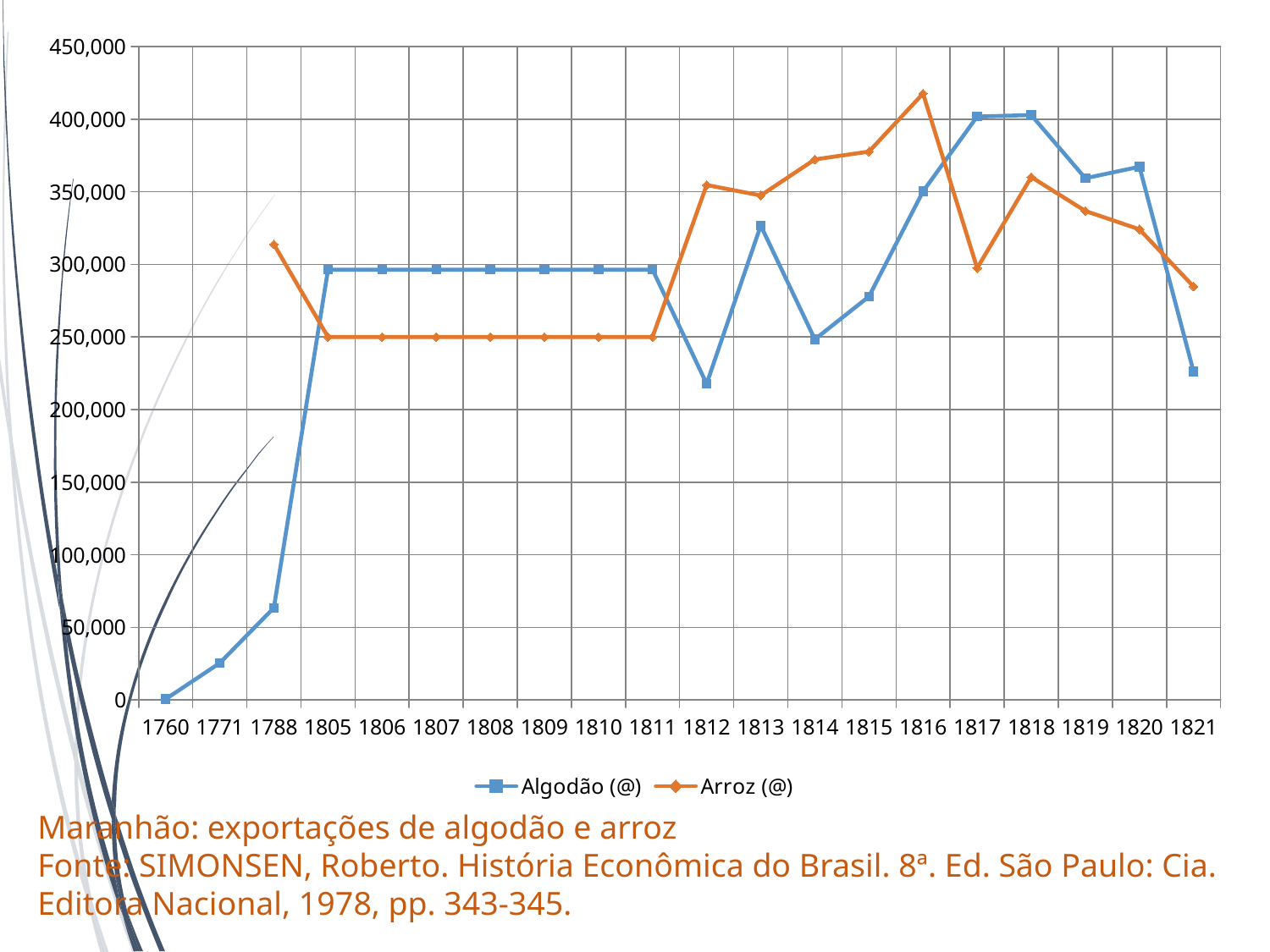
Does Algodão (@) rise or fall from 1760 to 1805? rise How many years are shown on the x axis? 20 Which series has the larger value in 1817, Algodão (@) or Arroz (@)? Algodão (@) Is the value for Algodão (@) in 1788 greater or less than 50,000? greater What is the value of Arroz (@) in 1808? 250,000 In which year is Arroz (@) at its highest? 1816 What kind of chart is shown on the slide? line chart How many series does the legend list? 2 Is the value for Algodão (@) in 1812 greater or less than 250,000? less In which year is Algodão (@) at its lowest? 1760 Is the value for Arroz (@) in 1816 greater or less than 400,000? greater Which series has the larger value in 1812, Algodão (@) or Arroz (@)? Arroz (@)